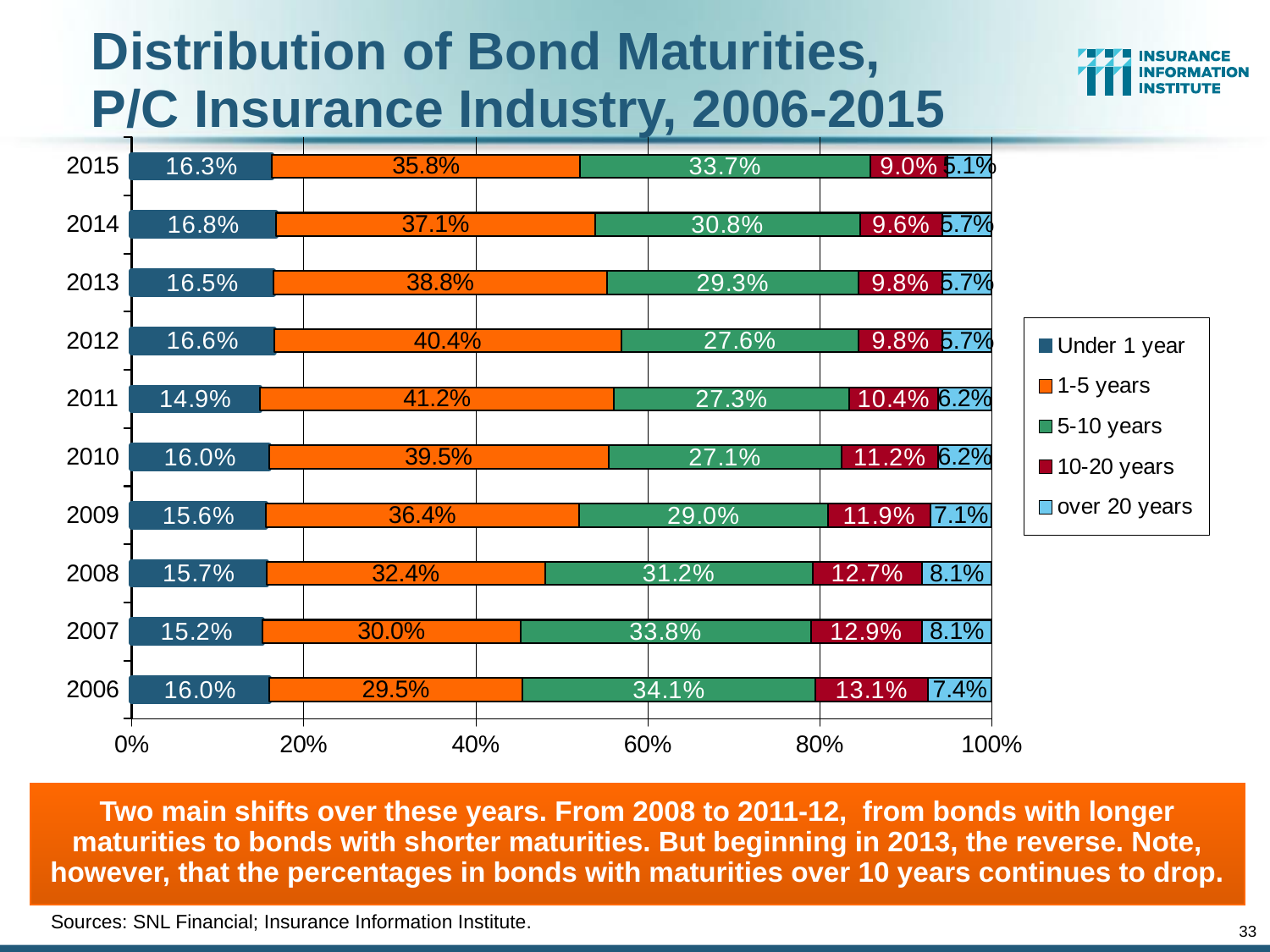
Which year had a larger share of bonds with 5-10 year maturities, 2014 or 2015? 2015 Does the share of bonds with 10-20 year maturities rise or fall from 2006 to 2015? Fall How many years are shown on the chart? 10 Which maturity category is shown in orange? 1-5 years In which year was the share of bonds with 1-5 year maturities highest? 2011 By how many percentage points did the 1-5 years share in 2012 exceed the 1-5 years share in 2006? 10.9 percentage points What percentage of bonds had maturities of 5-10 years in 2006? 34.1% In which year was the share of bonds with 10-20 year maturities lowest? 2015 How many series does the legend list? 5 What was the share of bonds with maturities under 1 year in 2014? 16.8% What kind of chart is shown on the slide? Stacked bar chart What percentage of bonds had maturities of 1-5 years in 2011? 41.2%